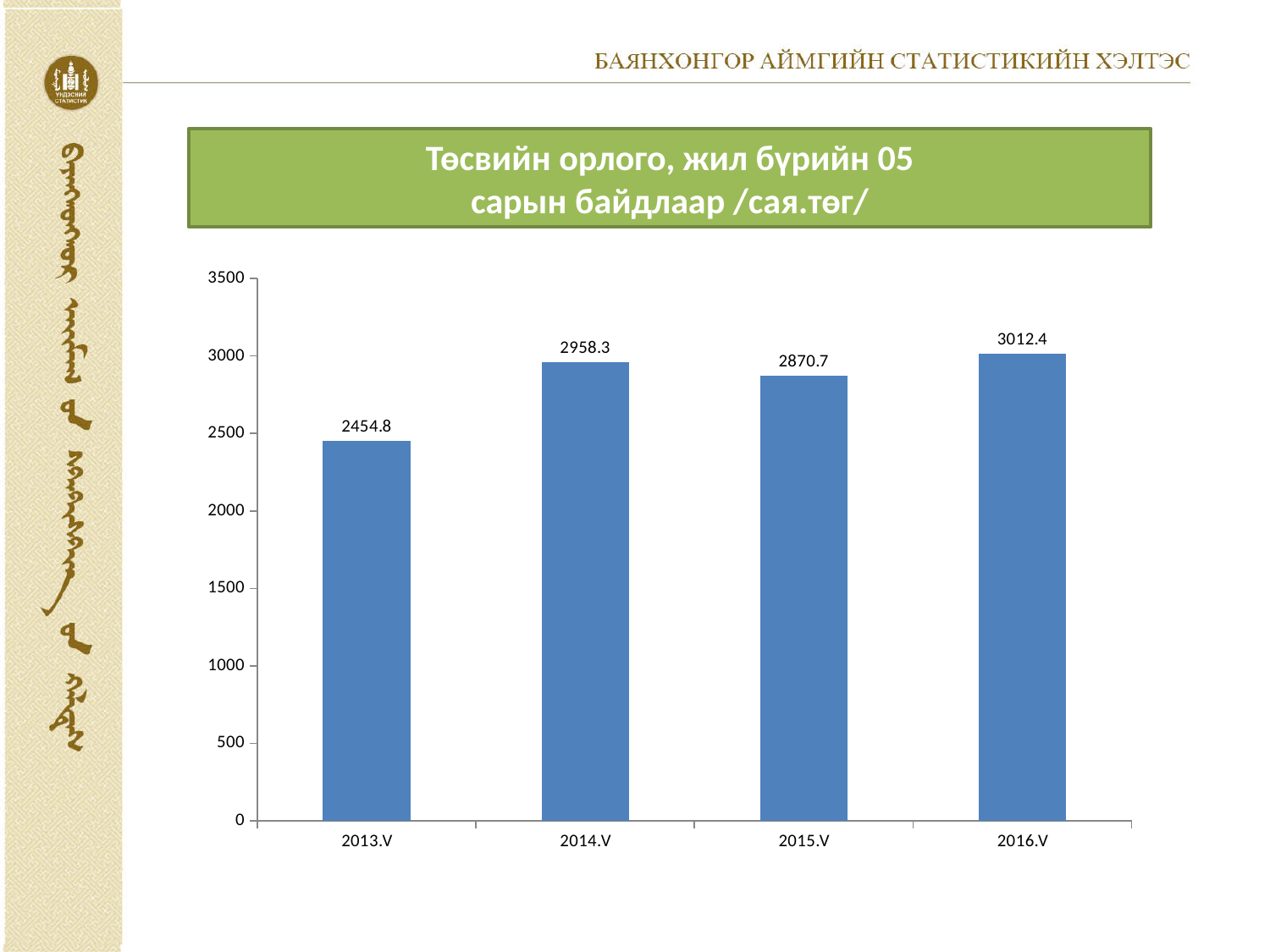
Which year has the lowest value? 2013.V Which year has the highest value? 2016.V Is the value for 2013.V greater or less than 2500? less How many bars are shown in the chart? 4 What is the value for 2016.V? 3012.4 What is the difference between the values for 2014.V and 2013.V? 503.5 What is the title of the chart? Төсвийн орлого, жил бүрийн 05 сарын байдлаар /сая.төг/ What kind of chart is shown on the slide? bar chart What is the value for 2013.V? 2454.8 What is the value for 2015.V? 2870.7 What is the difference between the values for 2016.V and 2015.V? 141.7 Which is larger, the value for 2014.V or the value for 2015.V? 2014.V